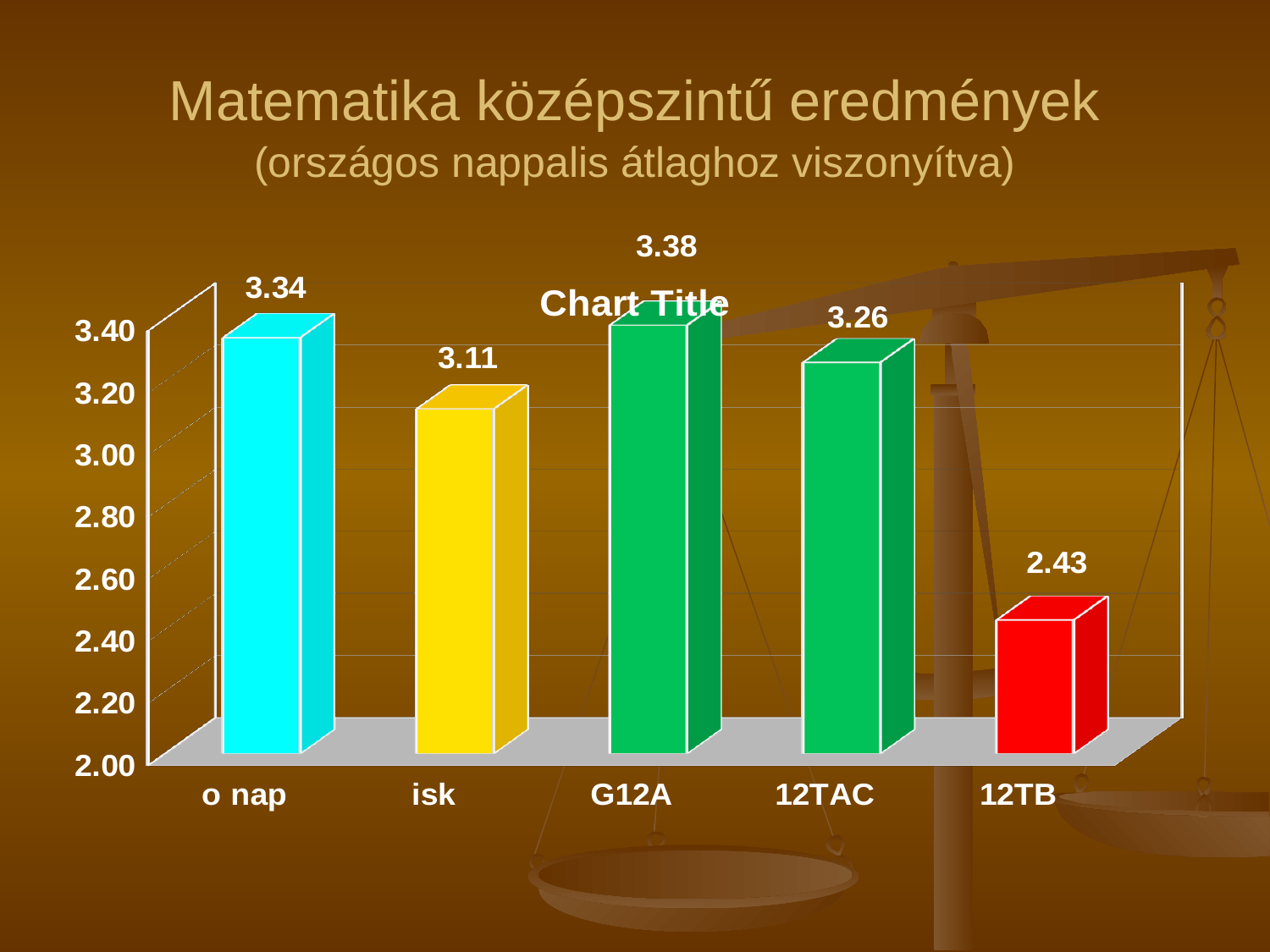
How many categories are shown on the x axis? 5 What is the difference between the values for G12A and 12TAC? 0.12 Is the value for 12TB greater or less than 2.60? less Which is larger, the value for 12TAC or the value for isk? 12TAC What kind of chart is shown on the slide? bar chart What is the value for isk? 3.11 Which category has the highest value? G12A What is the value for G12A? 3.38 Which category has the lowest value? 12TB What is the difference between the values for o nap and 12TB? 0.91 What colour is the bar for 12TB? red What is the value for 12TB? 2.43